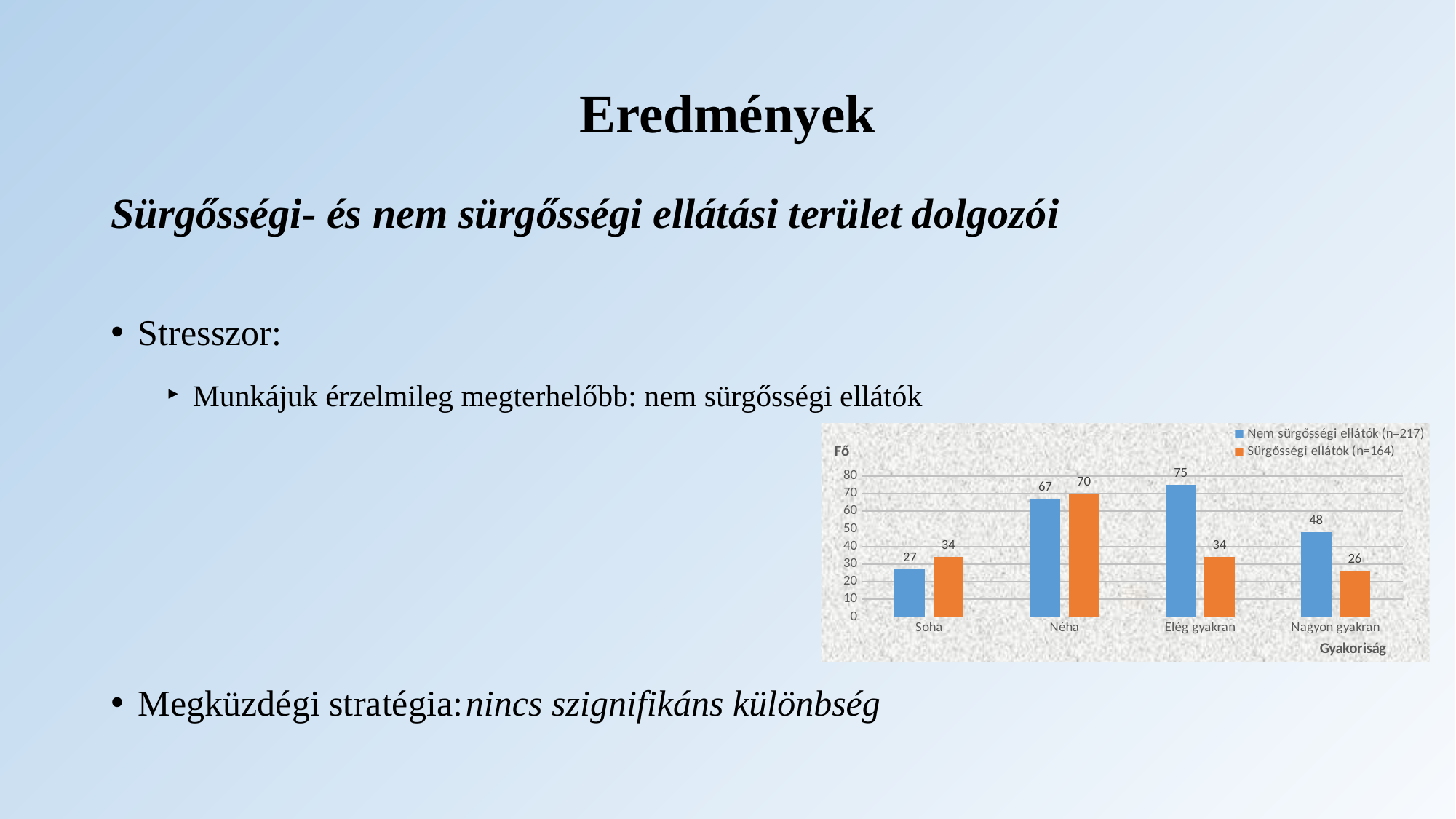
Which category has the lowest value for Sürgősségi ellátók (n=164)? Nagyon gyakran What is the value for Sürgősségi ellátók (n=164) at Néha? 70 What is the difference between Nem sürgősségi ellátók (n=217) and Sürgősségi ellátók (n=164) at Elég gyakran? 41 How many series does the legend list? 2 What is the value for Sürgősségi ellátók (n=164) at Nagyon gyakran? 26 What is the value for Nem sürgősségi ellátók (n=217) at Soha? 27 How many categories are shown on the x axis? 4 At Soha, which series has the larger value? Sürgősségi ellátók (n=164) Which category has the highest value for Nem sürgősségi ellátók (n=217)? Elég gyakran What is the label of the x axis? Gyakoriság What is the value for Nem sürgősségi ellátók (n=217) at Elég gyakran? 75 What kind of chart is shown on the slide? bar chart